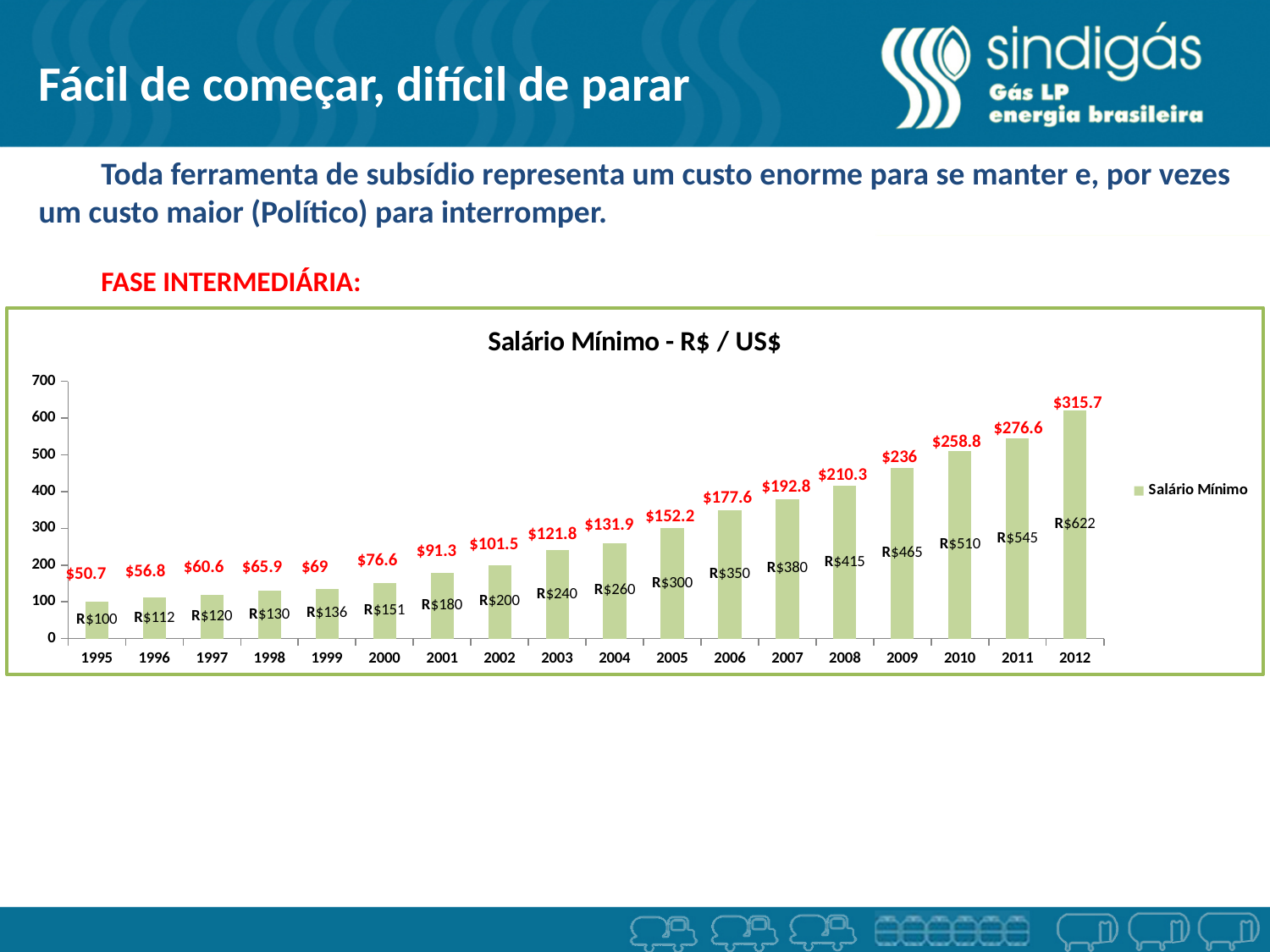
What is the R$ value of the minimum wage for 2003? R$240 What is the US$ value labelled for 2008? $210.3 Which year has the lowest minimum wage in the chart? 1995 Which year has the highest minimum wage in the chart? 2012 How many years are plotted on the x axis of the chart? 18 What is the difference in R$ between the minimum wage in 2012 and in 2011? R$77 How many series does the chart's legend list? 1 What is the title of the chart? Salário Mínimo - R$ / US$ Is the bar for 2010 greater or less than 400 on the axis? greater What kind of chart is shown on the slide? bar chart Which year has a larger minimum wage in R$, 2005 or 2009? 2009 Do the minimum wage values rise or fall from 1995 to 2012? rise